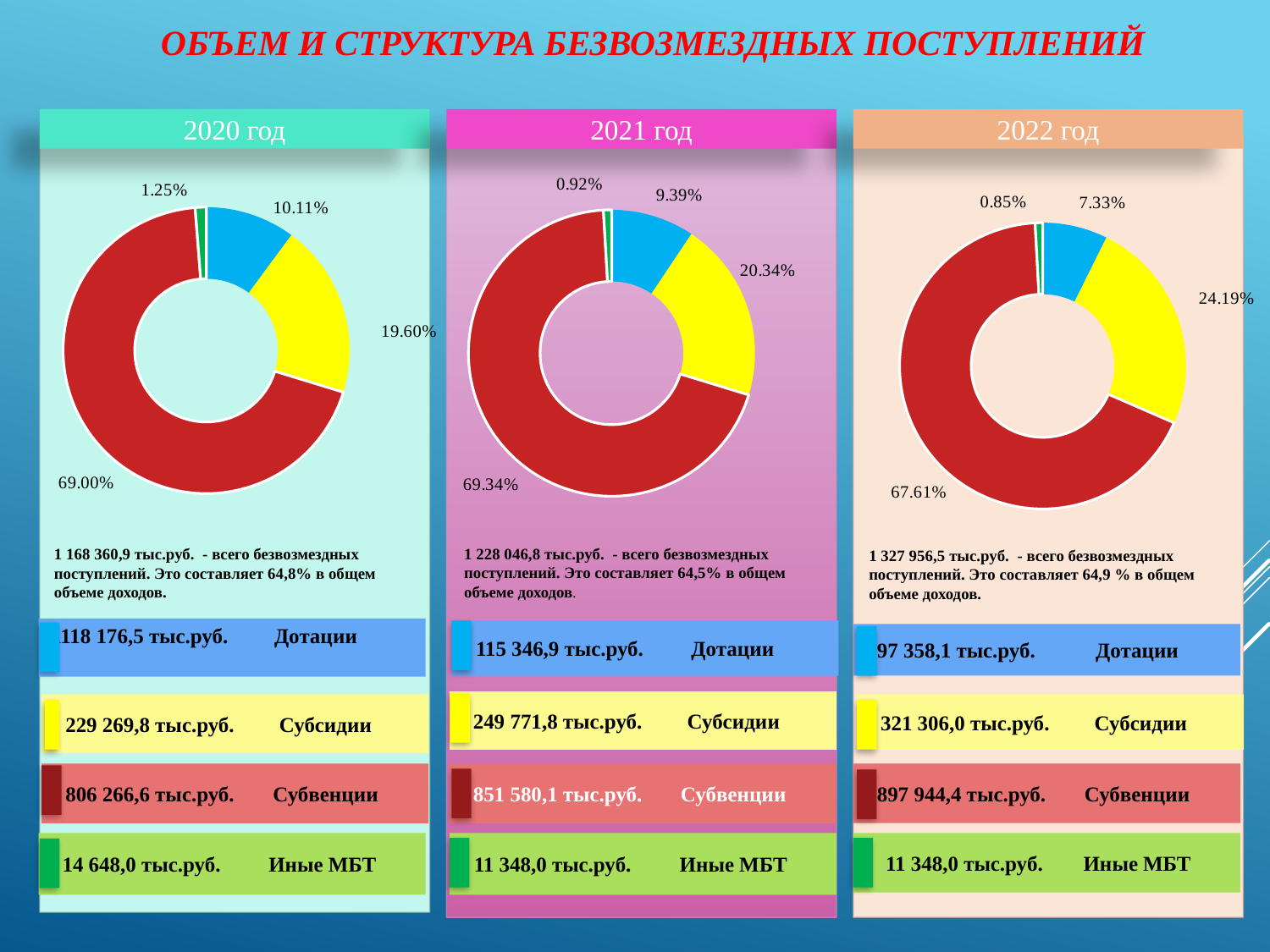
In the 2022 год chart, what share does the green (Иные МБТ) slice have? 0.85% In the 2022 год chart, which is larger: the Дотации slice or the Субсидии slice? Субсидии What is the title of the slide? ОБЪЕМ И СТРУКТУРА БЕЗВОЗМЕЗДНЫХ ПОСТУПЛЕНИЙ What is the difference between the Субсидии share in 2022 год (24.19%) and in 2020 год (19.60%)? 4.59% In the 2020 год chart, what share does the red (Субвенции) slice have? 69.00% In the 2020 год chart, which slice is the largest? Субвенции (69.00%) How does the Субвенции share change from 2020 год to 2022 год? It falls (69.00% to 67.61%) In the 2021 год chart, which slice is the smallest? Иные МБТ (0.92%) How many slices does the 2021 год chart have? 4 In the 2021 год chart, what share does the yellow (Субсидии) slice have? 20.34% What type of chart is used for each year on the slide? Doughnut (pie) chart